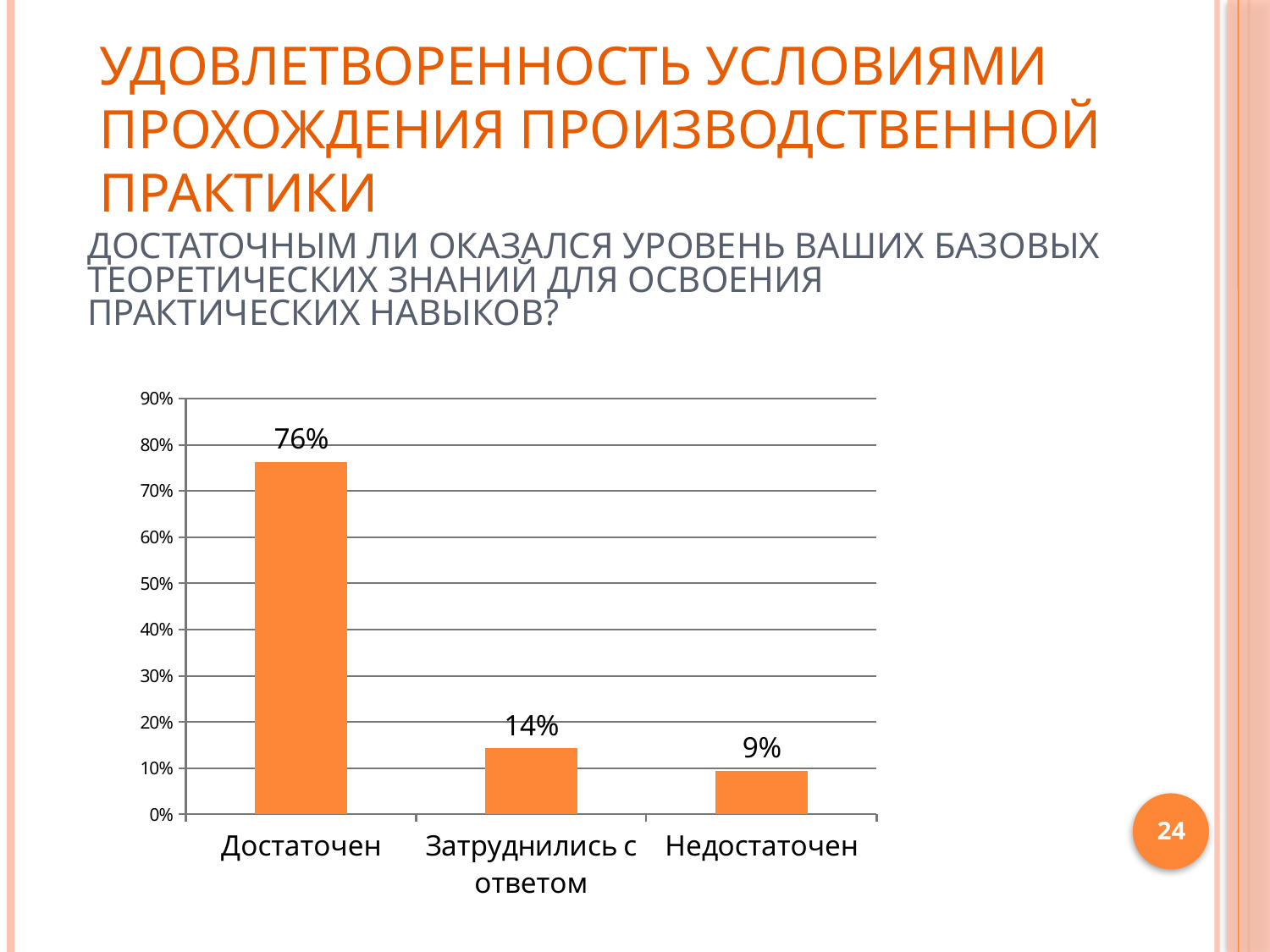
What is the value for Затруднились с ответом? 14% What is the difference between the values for Затруднились с ответом and Недостаточен? 5% What is the value for Достаточен? 76% What is the difference between the values for Достаточен and Недостаточен? 67% Which category has the highest value? Достаточен Is the value for Достаточен greater or less than 70%? greater Which category has the lowest value? Недостаточен Which is larger, the value for Затруднились с ответом or the value for Недостаточен? Затруднились с ответом How many categories are shown on the chart? 3 What is the value for Недостаточен? 9% What kind of chart is shown on the slide? bar chart What is the highest value shown on the vertical axis? 90%